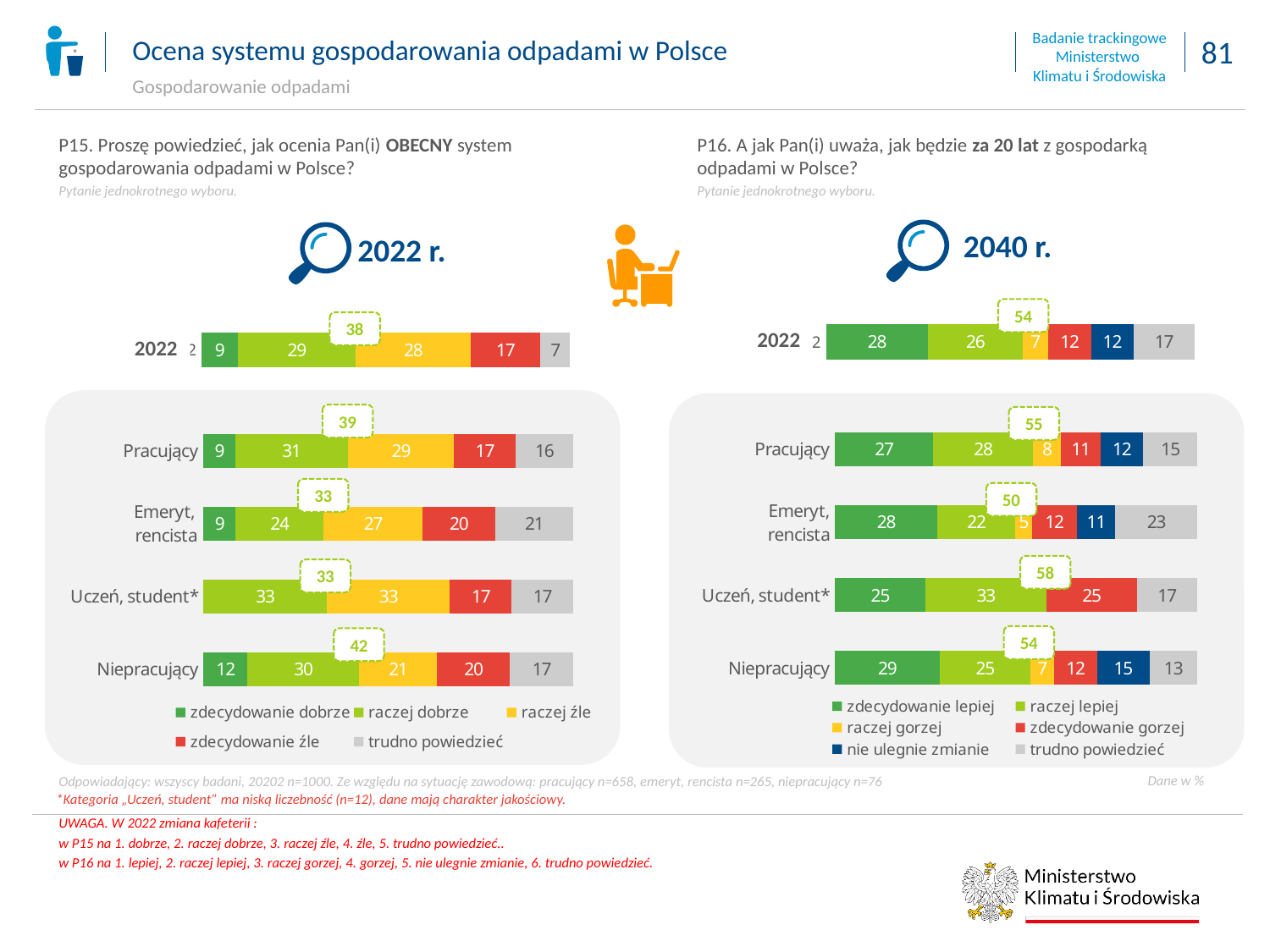
In the P15 chart (left, 2022 r.), which group has the highest value for 'zdecydowanie dobrze'? Niepracujący In the P16 chart (right, 2040 r.), what is the value for 'trudno powiedzieć' in the Emeryt, rencista group? 23 What type of chart is used on this slide? Stacked bar chart In the P16 chart (right, 2040 r.), what is the value for 'zdecydowanie lepiej' in the Niepracujący group? 29 In the P15 chart (left, 2022 r.), what is the value for 'trudno powiedzieć' in the Emeryt, rencista group? 21 How many groups (categories) are shown in the lower P15 chart (left, 2022 r.)? 4 How many series does the legend of the P16 chart (right, 2040 r.) list? 6 In the P16 chart (right, 2040 r.), which is larger: 'nie ulegnie zmianie' for Pracujący or for Niepracujący? Niepracujący In the P15 chart (left, 2022 r.), what is the difference between 'raczej dobrze' for Pracujący and for Emeryt, rencista? 7 In the P16 chart (right, 2040 r.), which group has the highest value for 'raczej lepiej'? Uczeń, student* In the P15 chart (left, 2022 r.), what is the value for 'zdecydowanie dobrze' in the Niepracujący group? 12 In the P15 chart (left, 2022 r.), what is the value for 'raczej dobrze' in the Pracujący group? 31